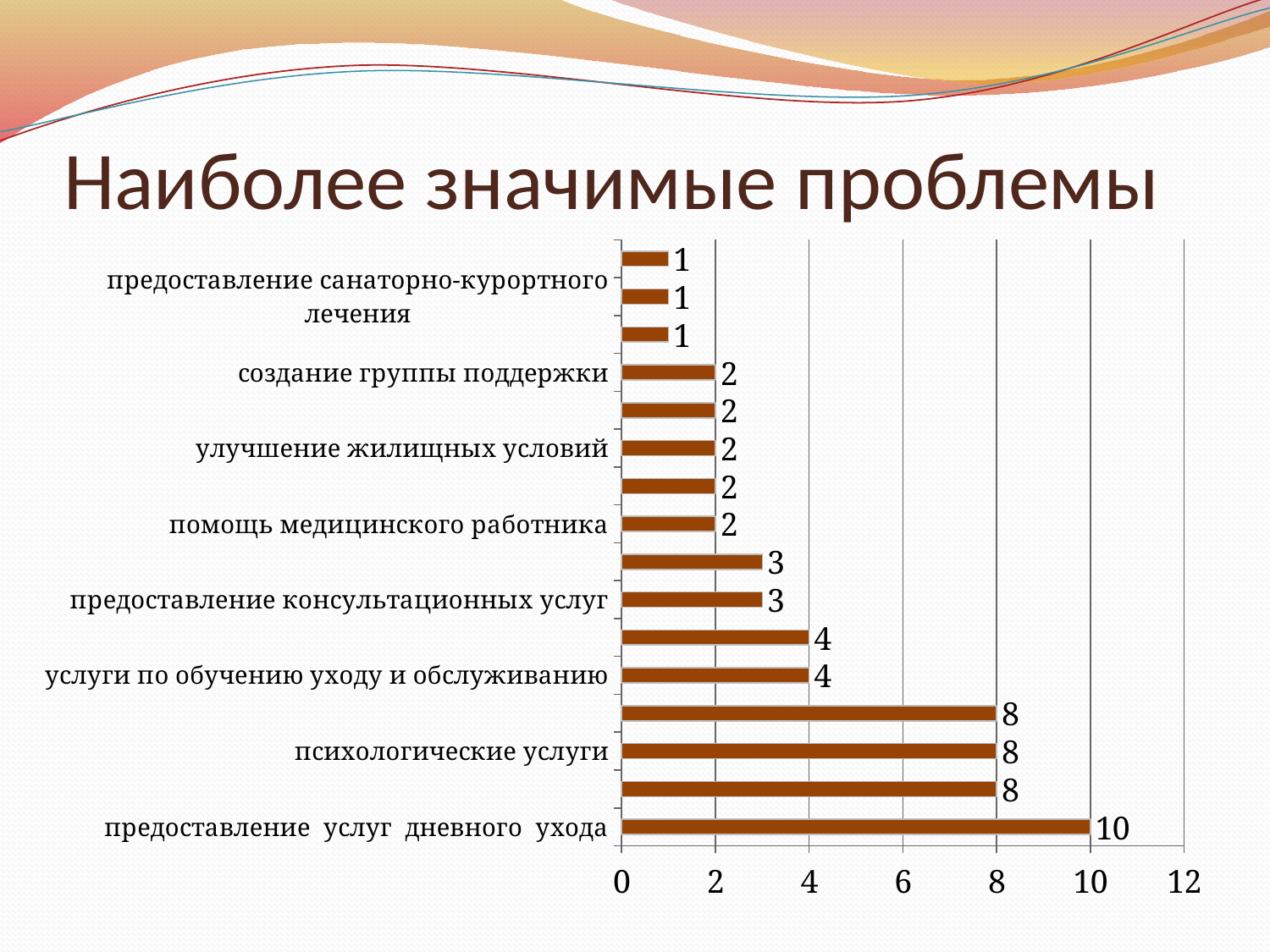
What is the value for "предоставление услуг дневного ухода"? 10 What is the title of the slide? Наиболее значимые проблемы What is the value for "услуги по обучению уходу и обслуживанию"? 4 What is the value for "помощь медицинского работника"? 2 What is the difference between the values for "предоставление услуг дневного ухода" and "психологические услуги"? 2 What is the value for "предоставление санаторно-курортного лечения"? 1 What is the value for "психологические услуги"? 8 How many bars are plotted in the chart? 16 Which is larger: the value for "услуги по обучению уходу и обслуживанию" or for "предоставление консультационных услуг"? услуги по обучению уходу и обслуживанию What kind of chart is shown on the slide? bar chart Which category has the highest value? предоставление услуг дневного ухода What is the value for "предоставление консультационных услуг"? 3